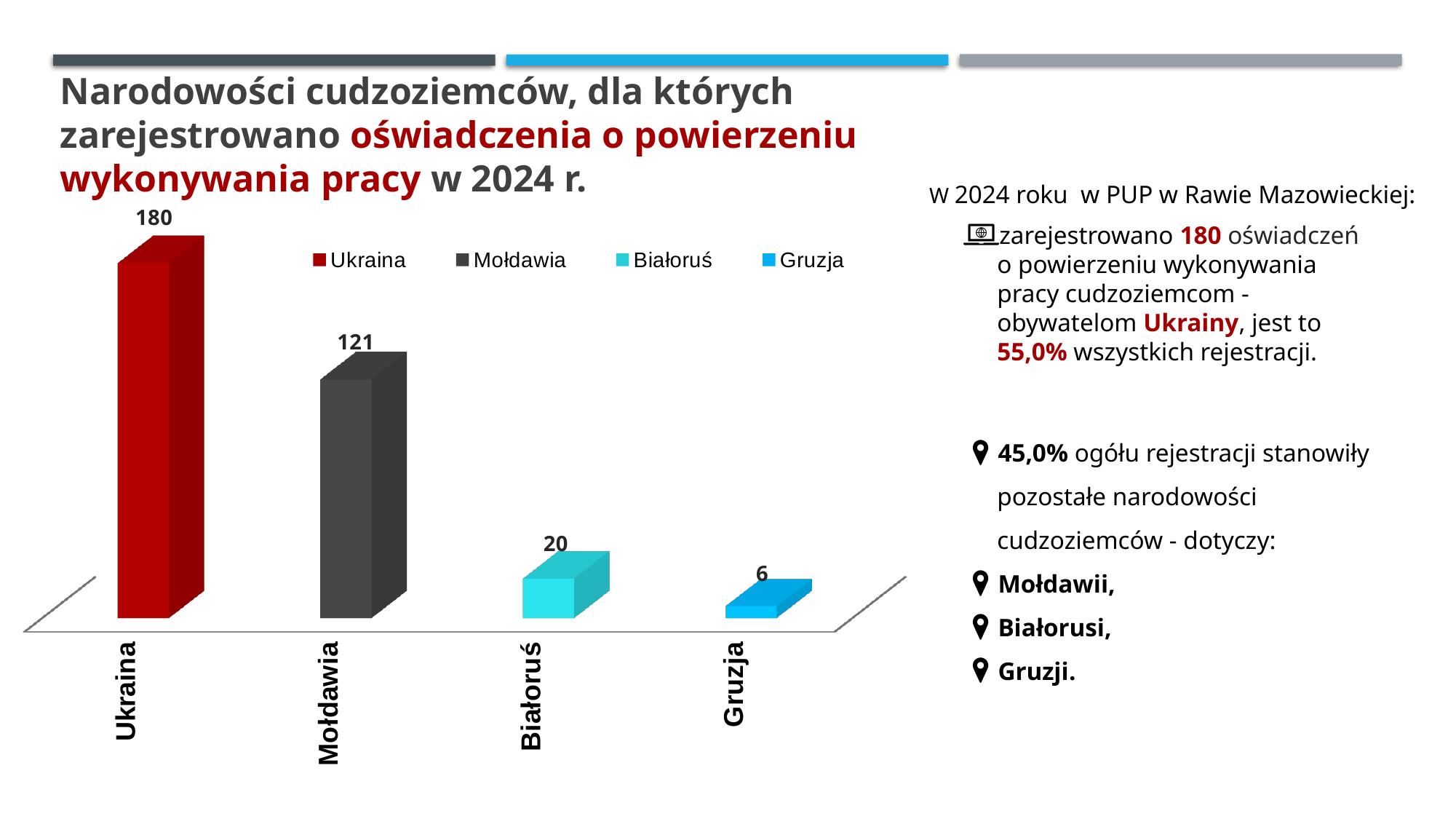
What is the difference between the values for Białoruś and Gruzja? 14 How many entries does the legend list? 4 Which category has the lowest value? Gruzja What kind of chart is shown on the slide? bar chart What is the value for Mołdawia? 121 What is the value for Gruzja? 6 Which is larger, the value for Mołdawia or the value for Białoruś? Mołdawia What is the difference between the values for Ukraina and Mołdawia? 59 Which category has the highest value? Ukraina What is the value for Białoruś? 20 What is the value for Ukraina? 180 How many categories are shown in the chart? 4